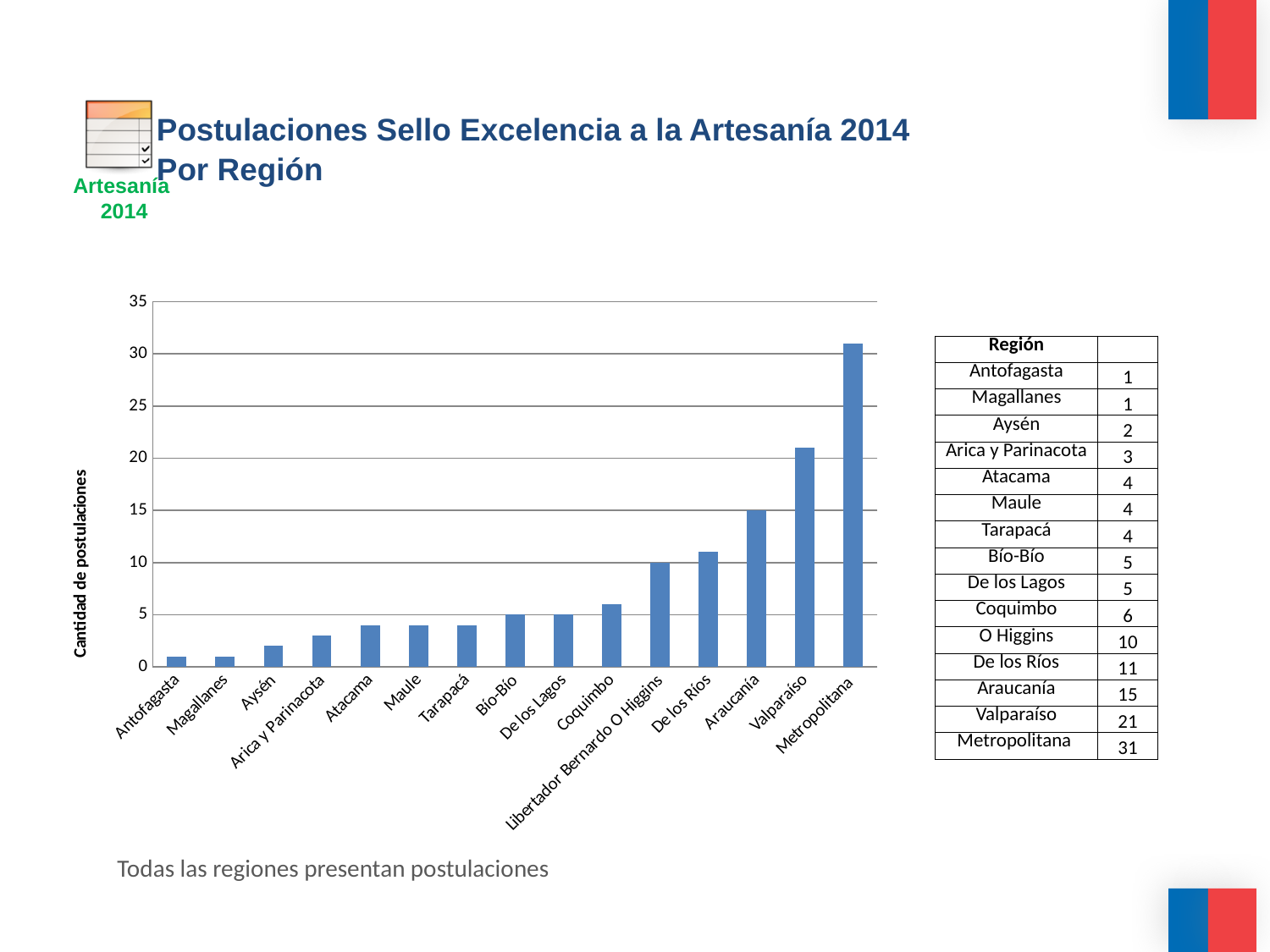
Do the values generally rise or fall from left to right along the x axis? rise Is the value for Valparaíso greater or less than 20? greater How many postulaciones does the Metropolitana region have? 31 How many regions are shown on the x axis of the chart? 15 How many postulaciones does Araucanía have? 15 Which region has the highest number of postulaciones? Metropolitana What kind of chart is shown on the slide? bar chart How many postulaciones does Valparaíso have? 21 Which has more postulaciones, De los Ríos or Coquimbo? De los Ríos What is the label of the vertical axis of the chart? Cantidad de postulaciones What is the title of the slide containing the chart? Postulaciones Sello Excelencia a la Artesanía 2014 Por Región What is the difference in postulaciones between Metropolitana and Valparaíso? 10